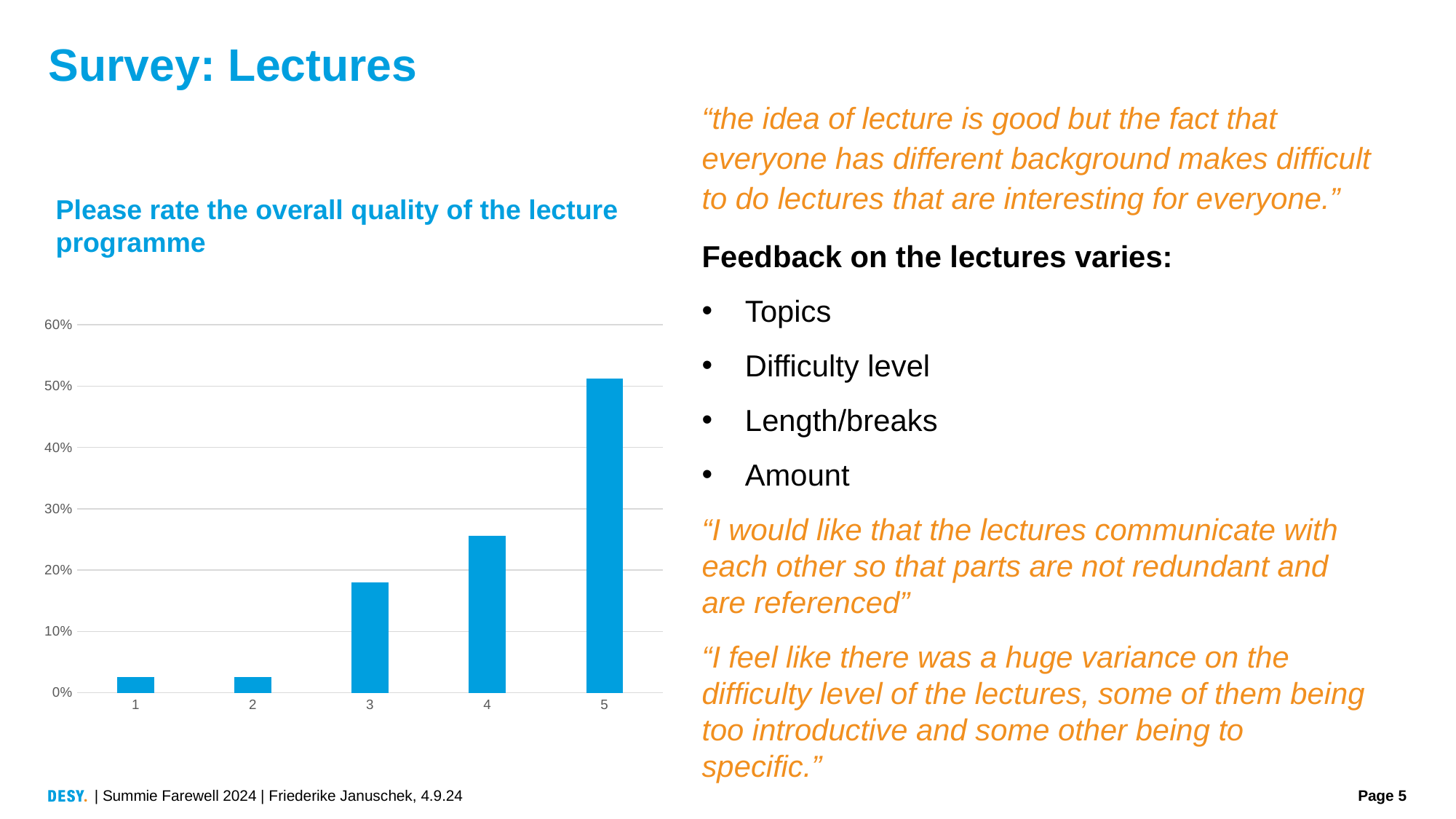
Is the value for rating 3 greater or less than 20%? less Do the values generally rise or fall as the rating increases from 1 to 5? rise Which has a larger value, rating 3 or rating 4? 4 Is the value for rating 3 greater or less than 10%? greater Is the value for rating 1 greater or less than 10%? less Which rating category has the highest value in the chart? 5 What kind of chart is shown on the slide? bar chart How many rating categories are shown on the x axis of the chart? 5 What is the title of the chart? Please rate the overall quality of the lecture programme